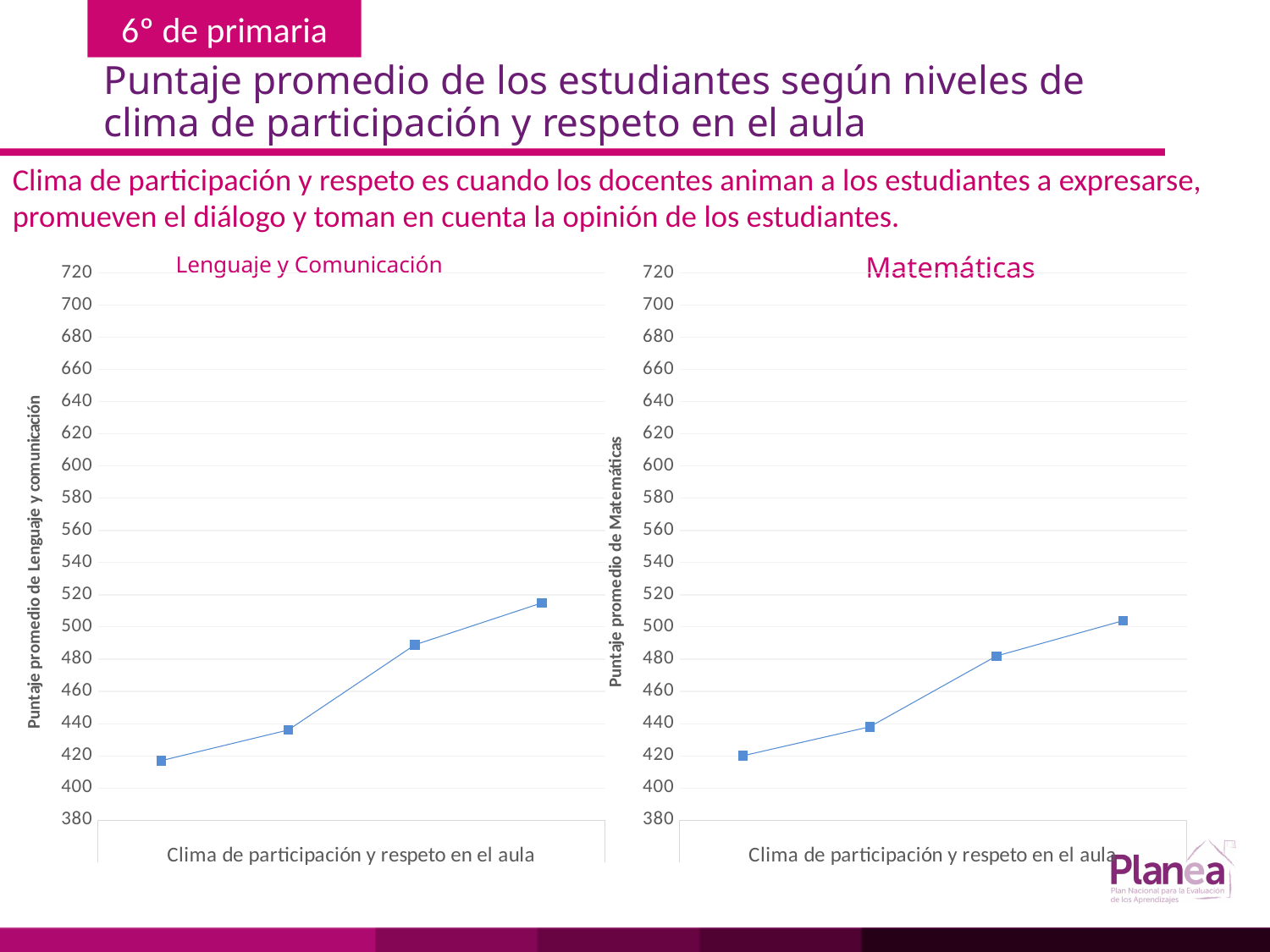
What kind of chart is the Lenguaje y Comunicación chart? line chart In the Lenguaje y Comunicación chart, which point has the highest value: the first, second, third or fourth? fourth In the Matemáticas chart, do the values rise or fall from left to right? rise In the Matemáticas chart, is the value of the last (rightmost) point greater or less than 480? greater In the Lenguaje y Comunicación chart, do the values rise or fall from left to right? rise What is the x-axis title of the Lenguaje y Comunicación chart? Clima de participación y respeto en el aula What is the y-axis title of the Matemáticas chart? Puntaje promedio de Matemáticas In the Matemáticas chart, is the value of the second point greater or less than 460? less In the Matemáticas chart, which point has the lowest value: the first, second, third or fourth? first In the Lenguaje y Comunicación chart, is the value of the last (rightmost) point greater or less than 500? greater How many data points are plotted in the Matemáticas chart? 4